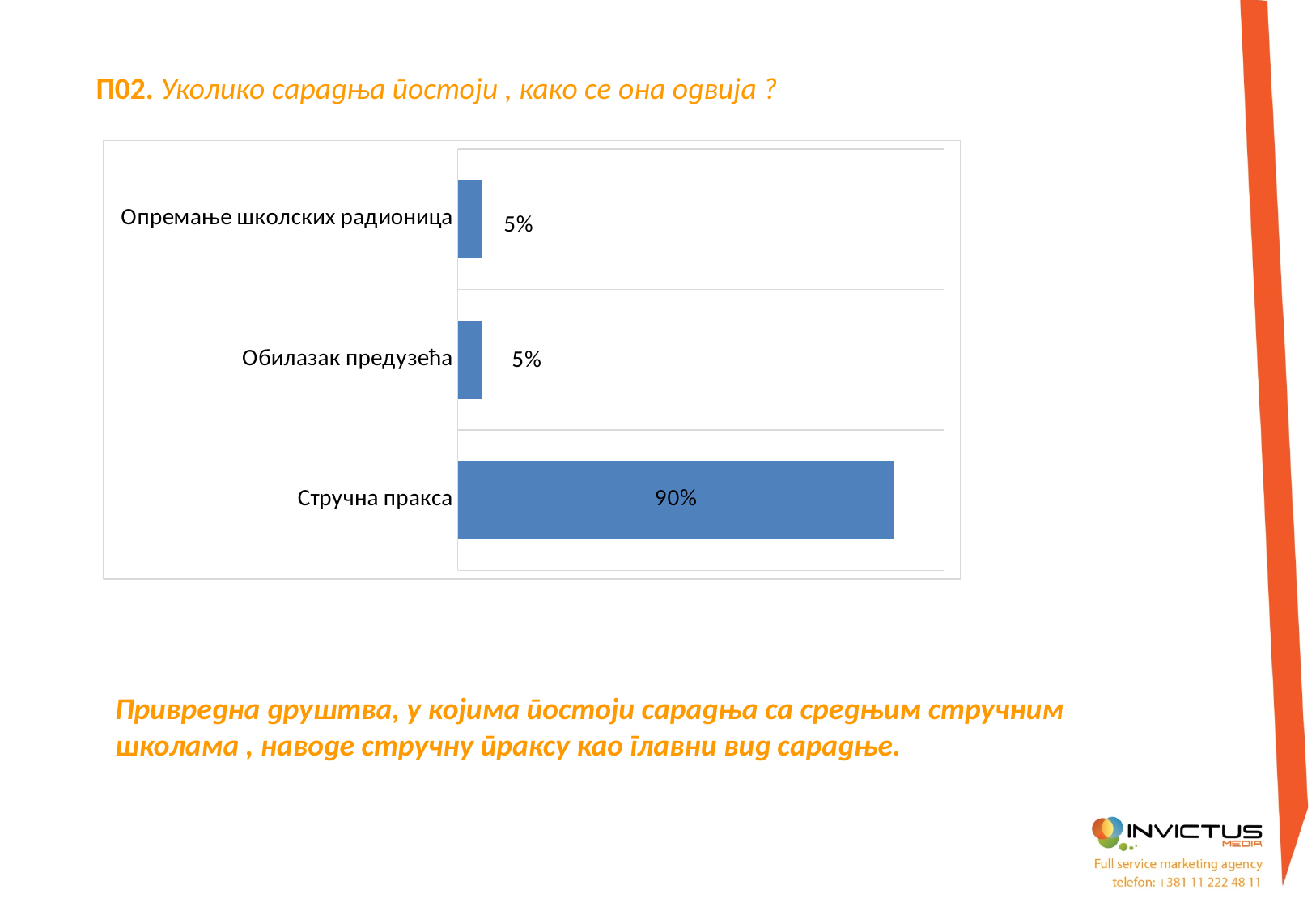
How many categories are shown in the chart? 3 What kind of chart is shown on the slide? Bar chart Do Обилазак предузећа and Опремање школских радионица have the same value? Yes What is the question number shown in the slide title? П02 What is the value for Стручна пракса? 90% What is the value for Опремање школских радионица? 5% What is the value for Обилазак предузећа? 5% What is the total of the three values shown in the chart? 100% Which is larger, the value for Стручна пракса or the value for Опремање школских радионица? Стручна пракса Which category has the highest value? Стручна пракса What is the difference between the values for Стручна пракса and Обилазак предузећа? 85% What colour are the bars in the chart? Blue